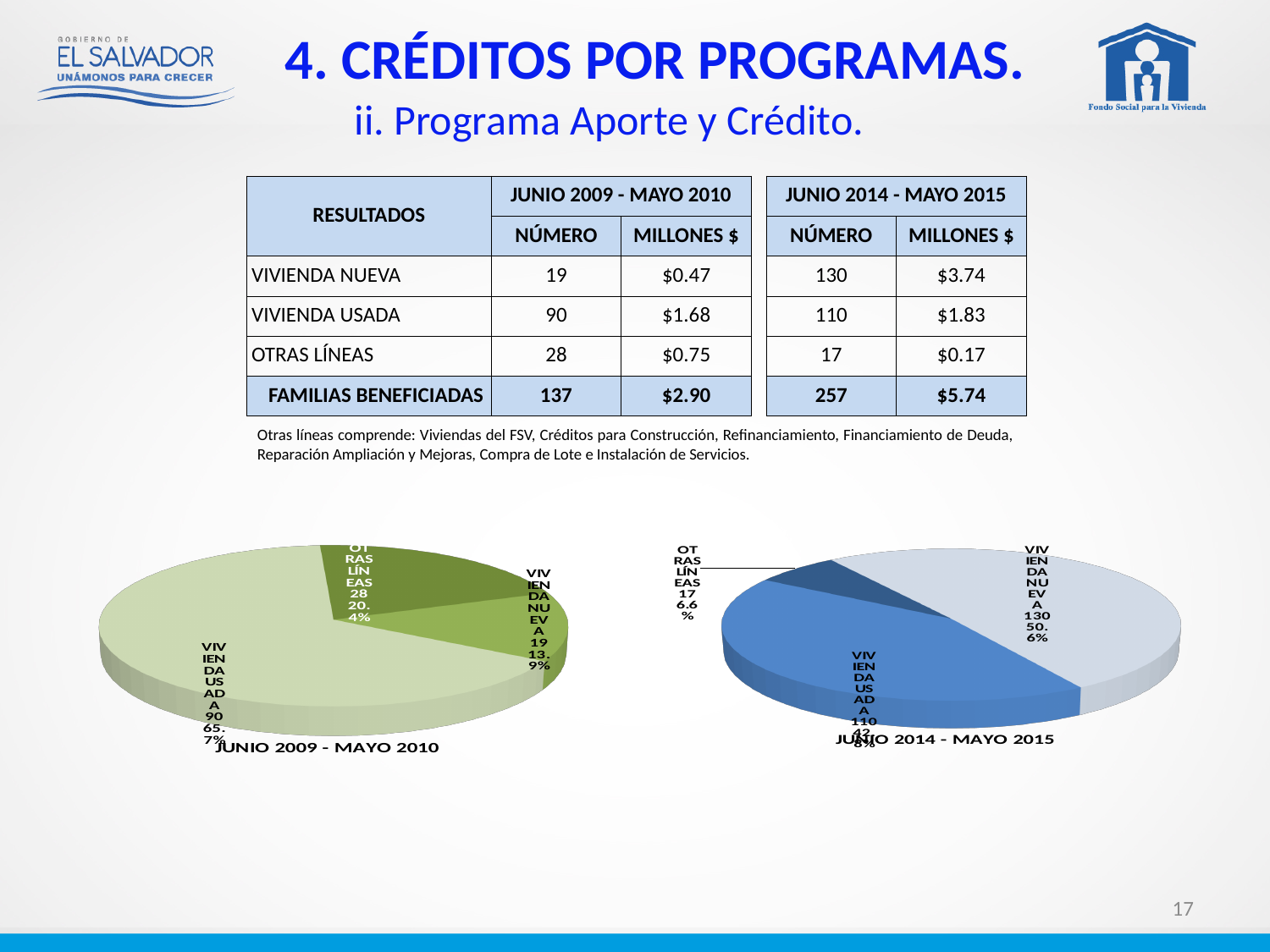
In the JUNIO 2009 - MAYO 2010 pie chart, which category has the largest slice? VIVIENDA USADA In the JUNIO 2014 - MAYO 2015 pie chart, what is the value for VIVIENDA NUEVA? 130 In the JUNIO 2009 - MAYO 2010 pie chart, what share does VIVIENDA NUEVA represent? 13.9% In the JUNIO 2009 - MAYO 2010 pie chart, how many slices are there? 3 In the JUNIO 2014 - MAYO 2015 pie chart, which category has the largest slice? VIVIENDA NUEVA In the JUNIO 2009 - MAYO 2010 pie chart, what share does OTRAS LÍNEAS represent? 20.4% What kind of chart is the JUNIO 2009 - MAYO 2010 chart? pie chart In the JUNIO 2014 - MAYO 2015 pie chart, what is the difference between the values for VIVIENDA NUEVA and OTRAS LÍNEAS? 113 In the JUNIO 2014 - MAYO 2015 pie chart, what share does OTRAS LÍNEAS represent? 6.6% In the JUNIO 2009 - MAYO 2010 pie chart, what is the value for VIVIENDA USADA? 90 In the JUNIO 2009 - MAYO 2010 pie chart, which is larger, OTRAS LÍNEAS or VIVIENDA NUEVA? OTRAS LÍNEAS In the JUNIO 2009 - MAYO 2010 pie chart, which category has the smallest slice? VIVIENDA NUEVA